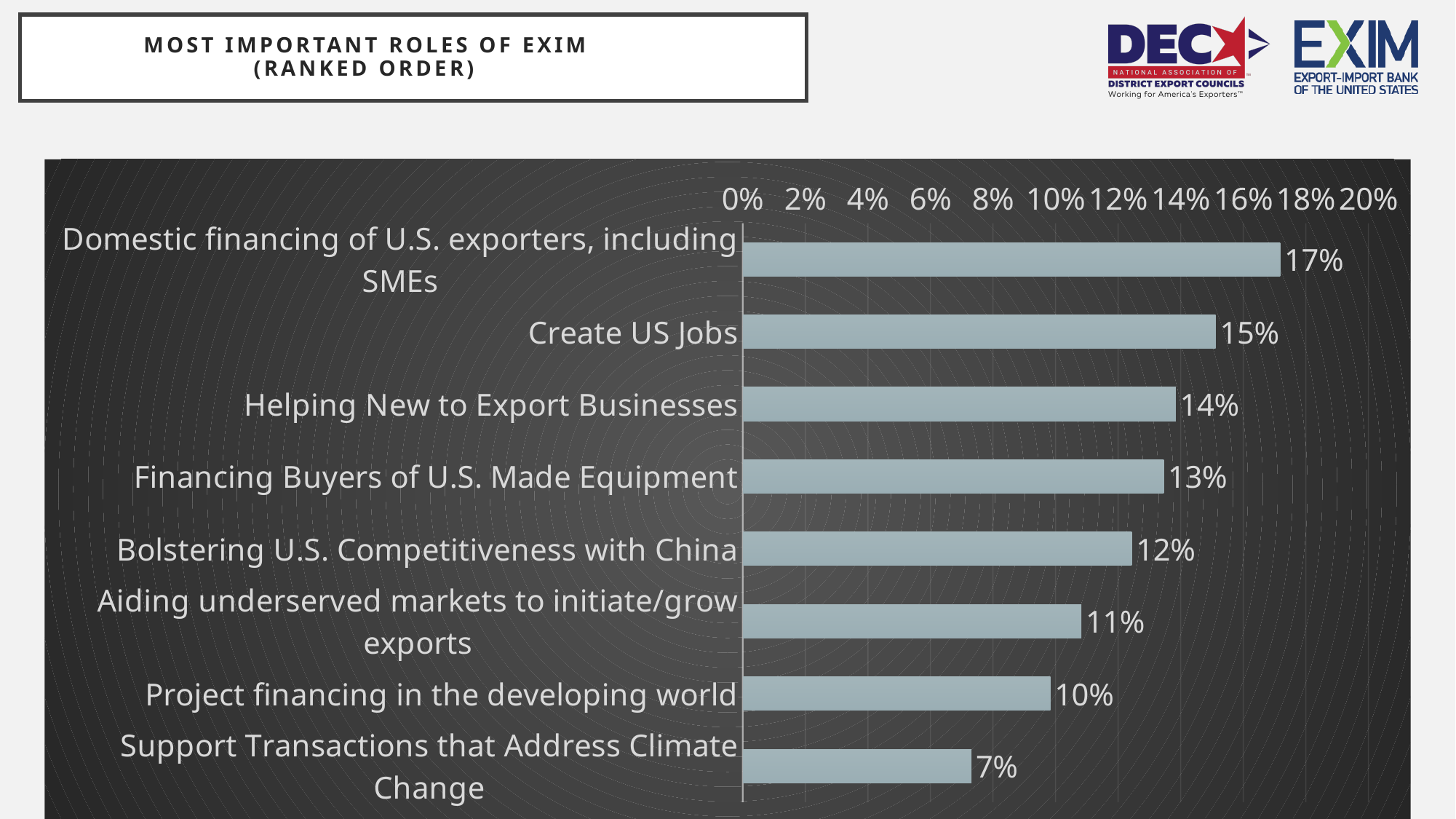
What is the difference between the values for Domestic financing of U.S. exporters, including SMEs and Project financing in the developing world? 7% What is the value for Bolstering U.S. Competitiveness with China? 12% Which category has the highest value? Domestic financing of U.S. exporters, including SMEs How many categories are shown in the chart? 8 What kind of chart is shown on the slide? bar chart Which category has the lowest value? Support Transactions that Address Climate Change Which is larger, the value for Helping New to Export Businesses or the value for Aiding underserved markets to initiate/grow exports? Helping New to Export Businesses Is the value for Financing Buyers of U.S. Made Equipment greater or less than 10%? greater What is the title of the chart? Most Important Roles of EXIM (Ranked Order) What is the value for Create US Jobs? 15% What is the value for Support Transactions that Address Climate Change? 7% What is the highest value shown on the percentage axis? 20%